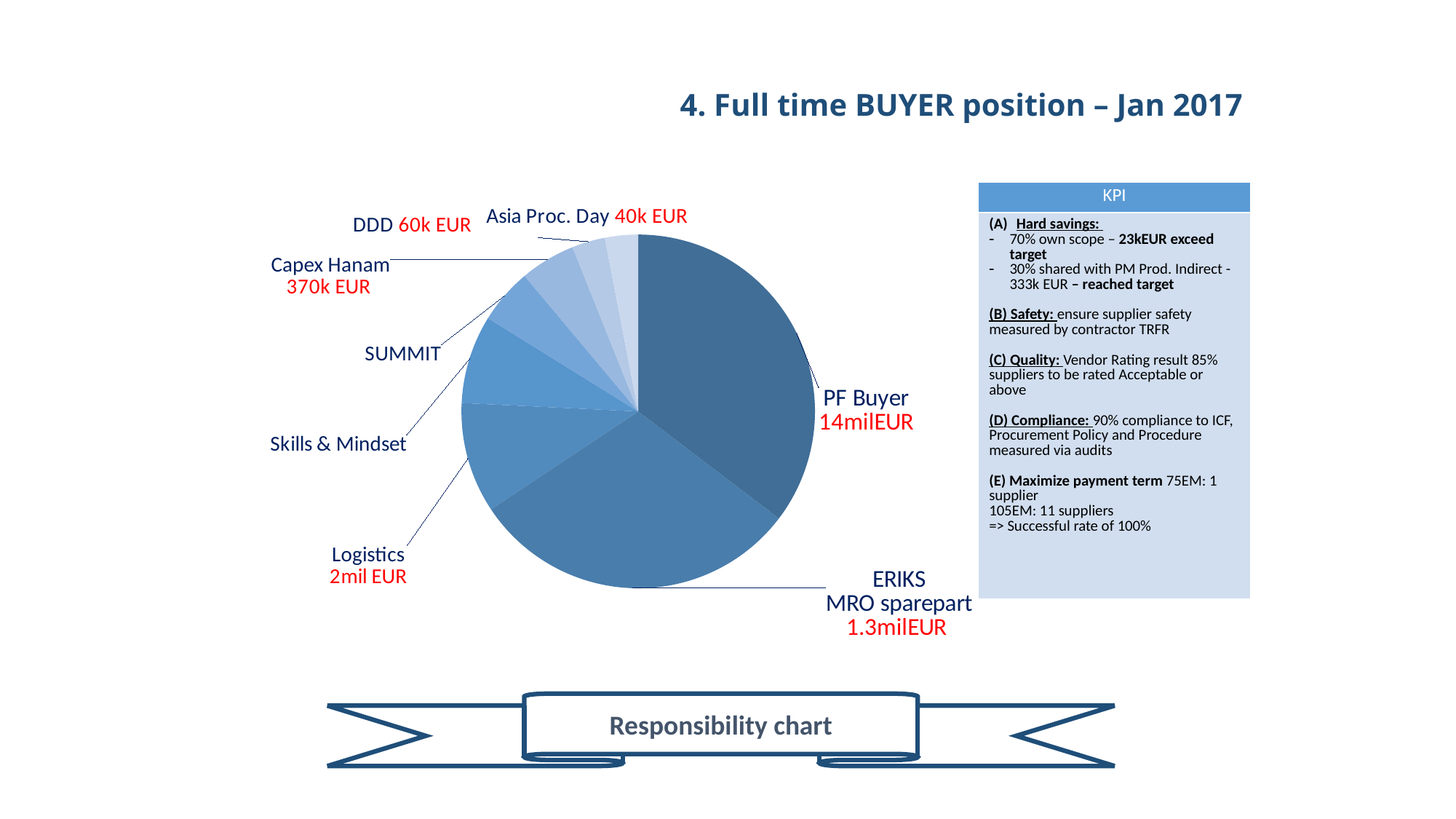
What kind of chart is shown on the slide? pie chart Which category has the largest slice of the pie? PF Buyer Which has the larger value, Capex Hanam or DDD? Capex Hanam What value is shown for Asia Proc. Day? 40k EUR What value is shown for PF Buyer in the pie chart? 14milEUR What is the difference between the values for DDD and Asia Proc. Day? 20k EUR How many categories are shown in the pie chart? 8 What value is shown for DDD? 60k EUR What value is shown for Logistics? 2mil EUR What value is shown for Capex Hanam? 370k EUR What value is shown for ERIKS MRO sparepart? 1.3milEUR